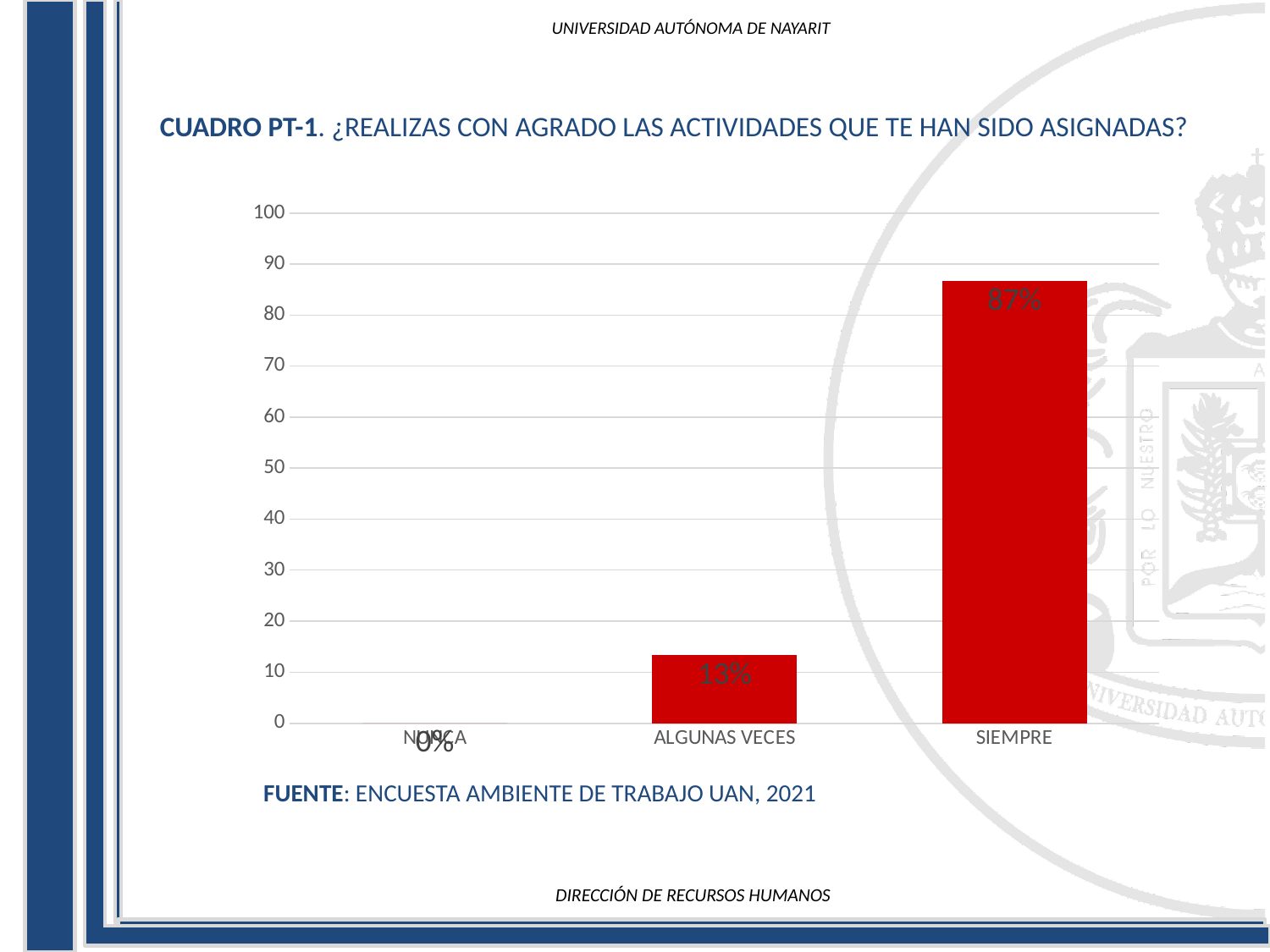
What is the value for NUNCA? 0% What is the value for ALGUNAS VECES? 13% What is the difference between the values for SIEMPRE and ALGUNAS VECES? 74% Which category has the highest value? SIEMPRE How many categories are shown on the x axis? 3 What source is cited below the chart? ENCUESTA AMBIENTE DE TRABAJO UAN, 2021 Is the value for ALGUNAS VECES greater or less than 20? less Which category has the lowest value? NUNCA What is the value for SIEMPRE? 87% Which is larger, the value for ALGUNAS VECES or the value for SIEMPRE? SIEMPRE What kind of chart is shown on the slide? bar chart Is the value for SIEMPRE greater or less than 80? greater